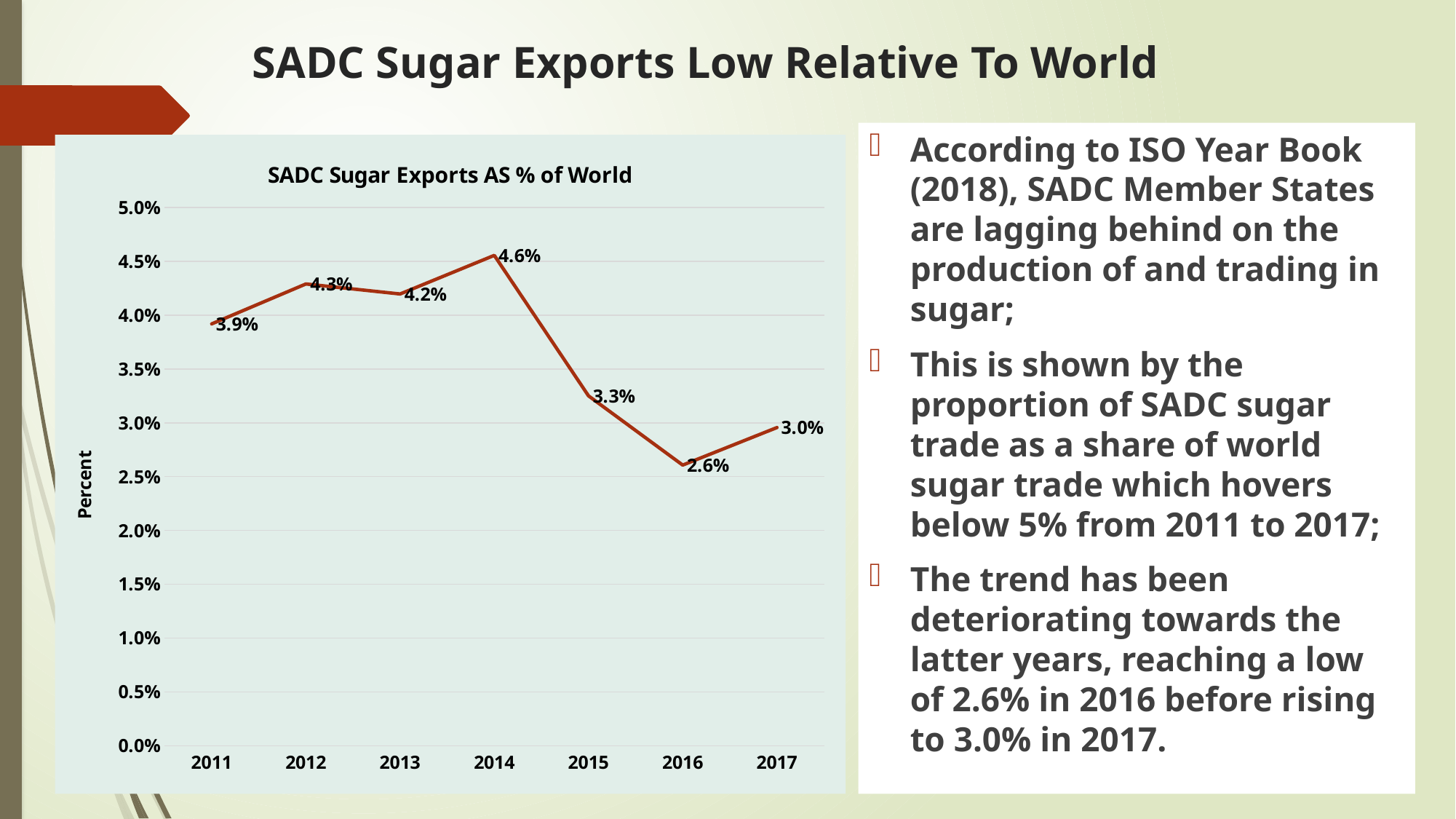
What is the value for 2014? 4.6% Which year has the lowest value? 2016 What type of chart is shown on the slide? line chart Which year has the highest value? 2014 Does the value rise or fall from 2014 to 2016? fall What is the value for 2016? 2.6% What is the difference between the values for 2014 and 2016? 2.0% Which is larger, the value for 2012 or the value for 2015? 2012 What is the label on the vertical axis? Percent How many years are plotted on the chart? 7 What is the title of the chart? SADC Sugar Exports AS % of World What is the value for 2011? 3.9%